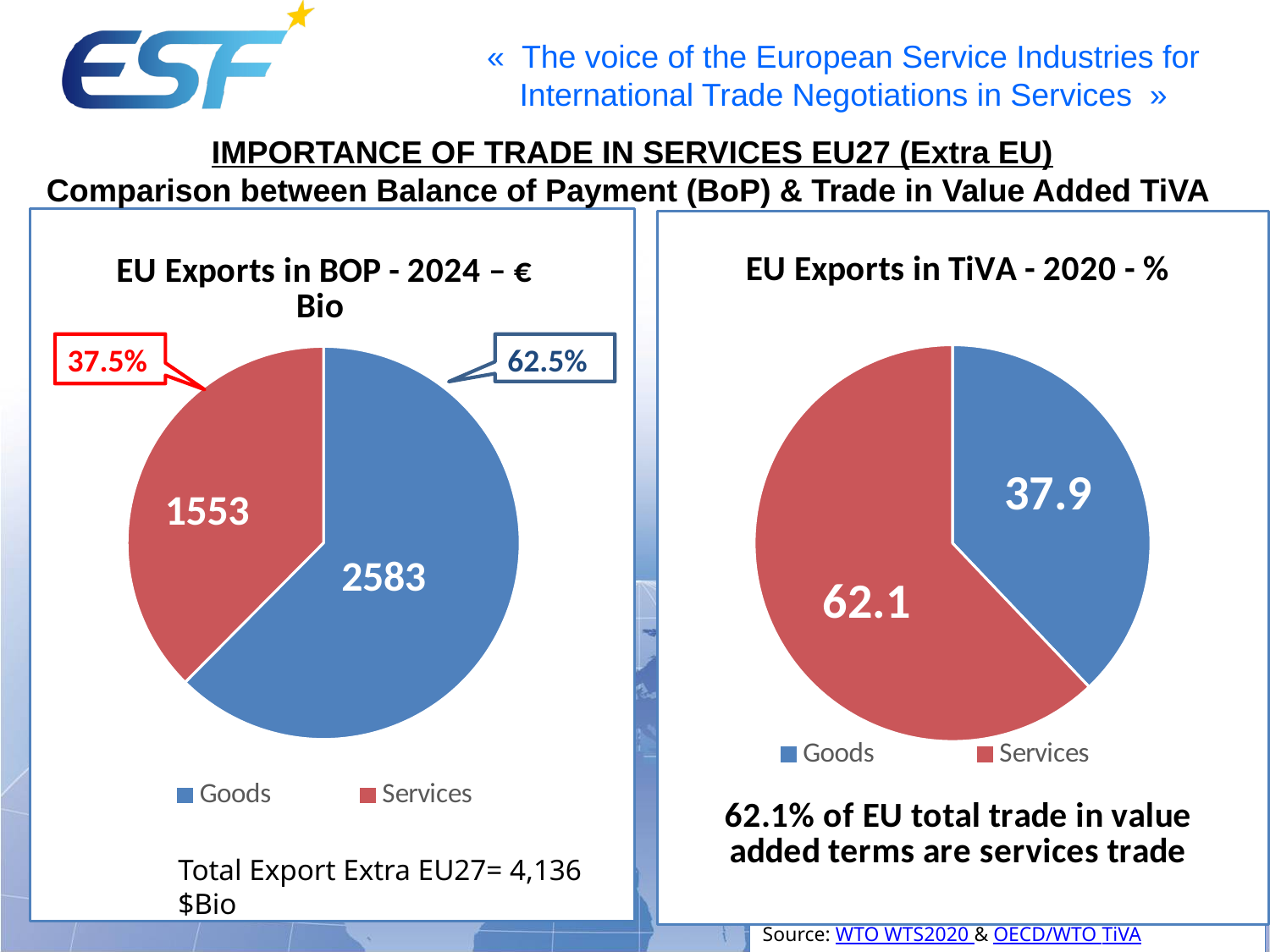
In the 'EU Exports in BOP - 2024' chart, what share of the pie does Services represent? 37.5% What type of chart is the 'EU Exports in TiVA - 2020' chart? Pie chart In the 'EU Exports in BOP - 2024' chart, which category is larger, Goods or Services? Goods How many categories does the legend of the 'EU Exports in BOP - 2024' chart list? 2 In the 'EU Exports in BOP - 2024' chart, what is the value for Services? 1553 In the 'EU Exports in TiVA - 2020' chart, what is the value for Goods? 37.9 In the 'EU Exports in TiVA - 2020' chart, what is the difference between the Services and Goods values? 24.2 In the 'EU Exports in BOP - 2024' chart, what is the value for Goods? 2583 In the 'EU Exports in BOP - 2024' chart, what share of the pie does Goods represent? 62.5% In the 'EU Exports in TiVA - 2020' chart, which category has the largest slice? Services In the 'EU Exports in BOP - 2024' chart, what is the difference between the Goods and Services values? 1030 In the 'EU Exports in TiVA - 2020' chart, what is the value for Services? 62.1